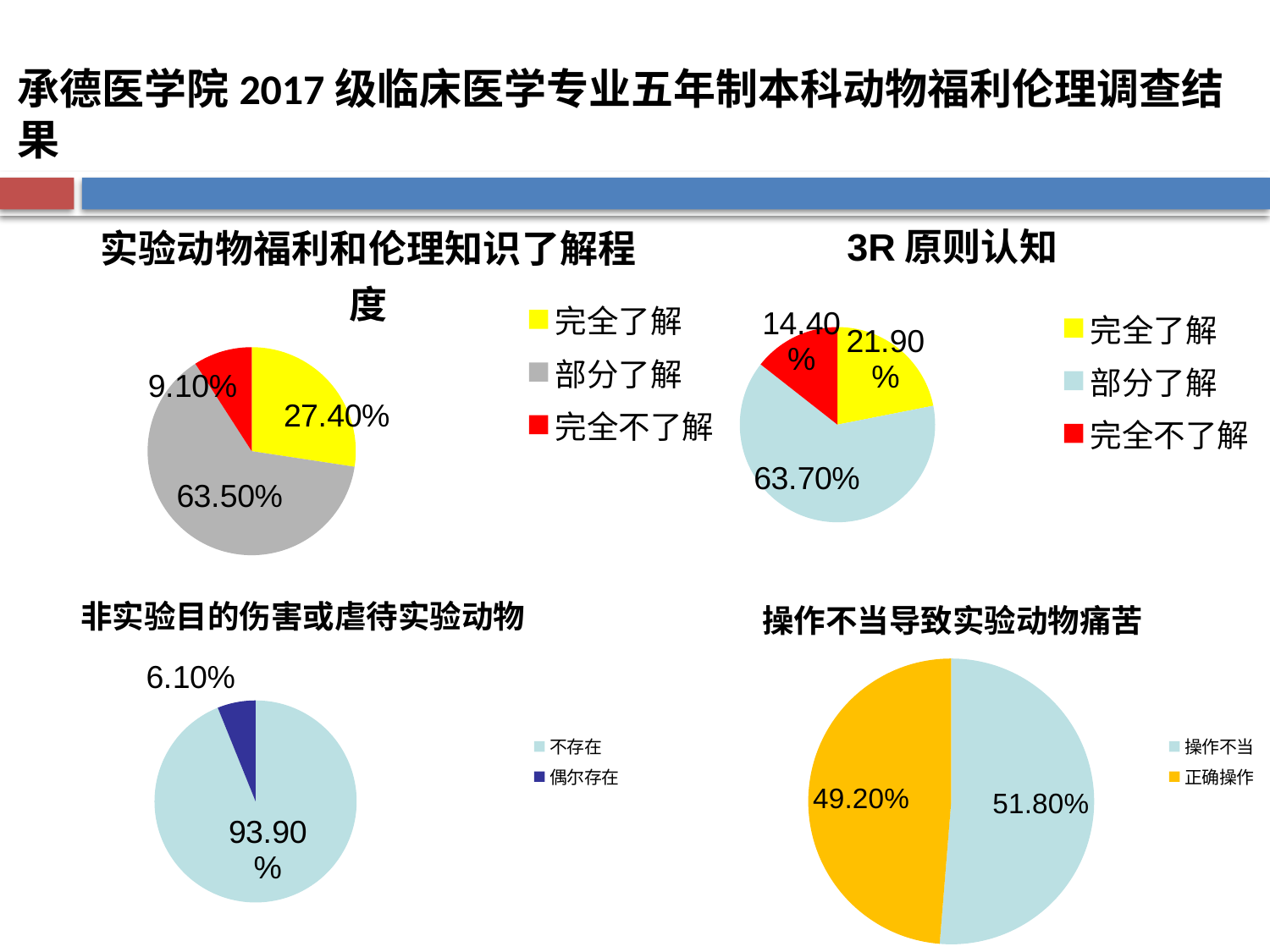
In the chart titled 非实验目的伤害或虐待实验动物, what percentage is shown for 偶尔存在? 6.10% How many slices does the chart titled 非实验目的伤害或虐待实验动物 have? 2 In the chart titled 实验动物福利和伦理知识了解程度, which category has the smallest share? 完全不了解 How many legend entries does the chart titled 3R 原则认知 list? 3 In the chart titled 3R 原则认知, what percentage is shown for 完全不了解? 14.40% In the chart titled 实验动物福利和伦理知识了解程度, what percentage is shown for 部分了解? 63.50% In the chart titled 3R 原则认知, which category has the largest share? 部分了解 In the chart titled 操作不当导致实验动物痛苦, what percentage is shown for 正确操作? 49.20% In the chart titled 3R 原则认知, which is larger: 完全了解 or 完全不了解? 完全了解 What type of chart is the chart titled 操作不当导致实验动物痛苦? Pie chart In the chart titled 操作不当导致实验动物痛苦, what is the difference between the 操作不当 and 正确操作 shares? 2.60% In the chart titled 实验动物福利和伦理知识了解程度, what is the difference between the 完全了解 and 完全不了解 shares? 18.30%